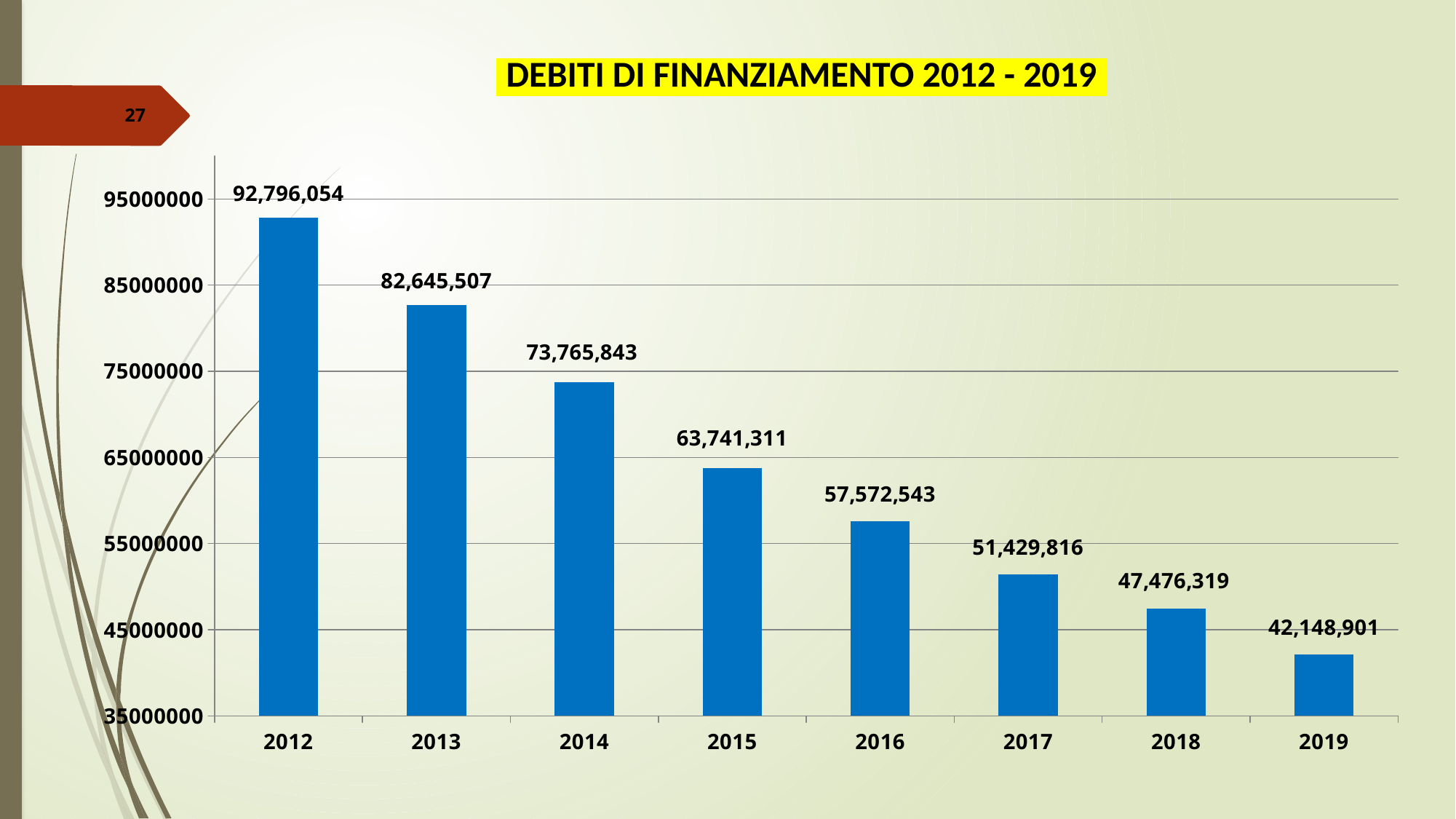
Which is larger, the value for 2014 or the value for 2015? 2014 What is the difference between the values for 2018 and 2019? 5,327,418 What kind of chart is shown on the slide? bar chart What is the value for 2016? 57,572,543 What is the value for 2019? 42,148,901 How many years are shown on the x axis? 8 Which year has the lowest value? 2019 Which year has the highest value? 2012 Is the value for 2017 greater or less than 55000000? less What is the value for 2012? 92,796,054 What is the difference between the values for 2012 and 2013? 10,150,547 Do the values rise or fall from 2012 to 2019? fall